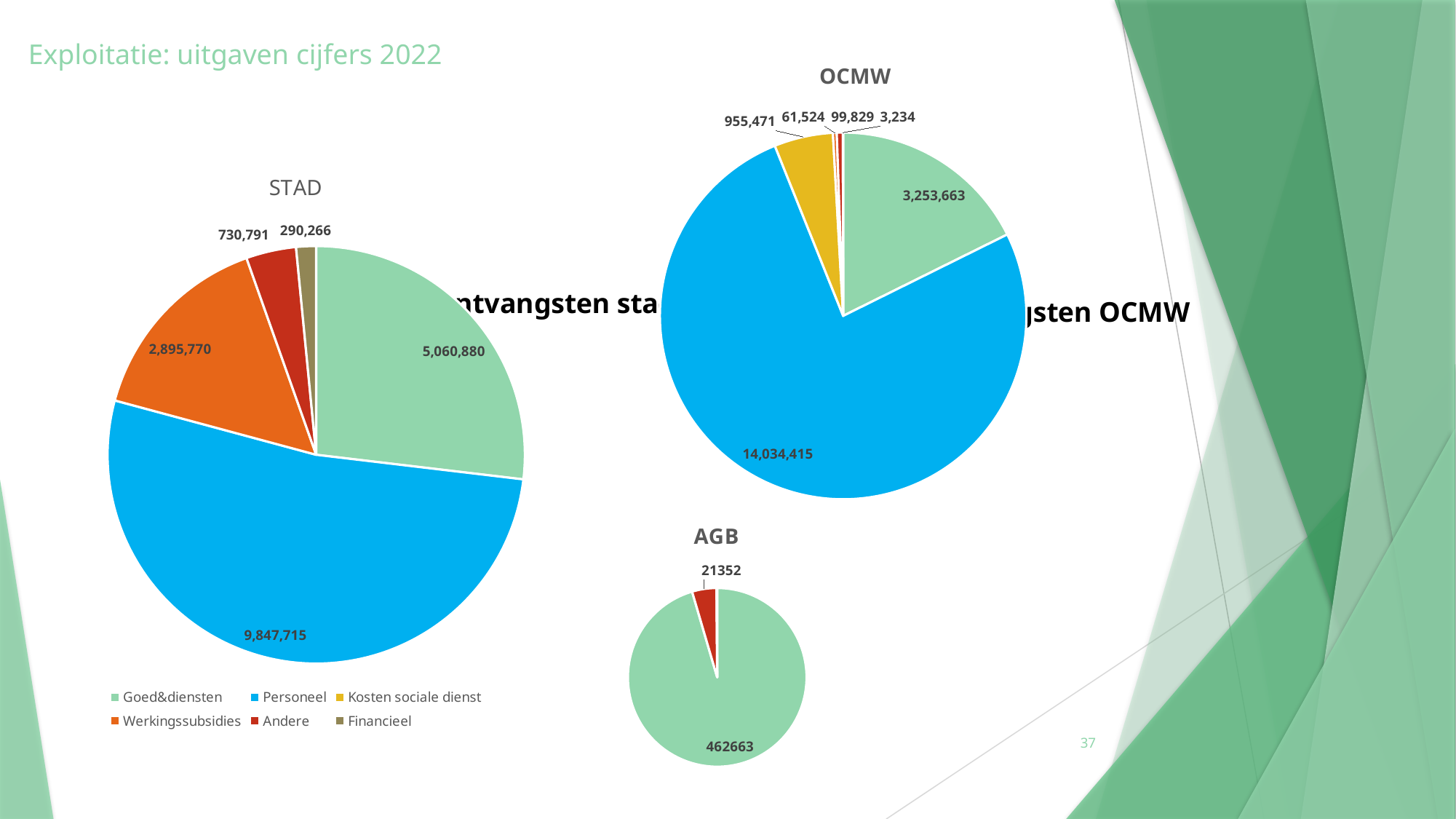
In the OCMW pie chart, what is the smallest labelled value? 3,234 In the STAD pie chart, which category has the largest slice? Personeel In the STAD pie chart, what is the difference between Personeel and Goed&diensten? 4,786,835 How many slices does the AGB pie chart have? 2 How many entries does the legend list? 6 In the OCMW pie chart, what is the value for Kosten sociale dienst? 955,471 In the AGB pie chart, what is the value of the larger slice (Goed&diensten)? 462663 In the STAD pie chart, what is the value for Personeel? 9,847,715 In the OCMW pie chart, what is the value for Goed&diensten? 3,253,663 In the STAD pie chart, what is the value for Werkingssubsidies? 2,895,770 Which is larger: Personeel in the STAD chart or Personeel in the OCMW chart? Personeel in the OCMW chart In the STAD pie chart, which category has the smallest slice? Financieel